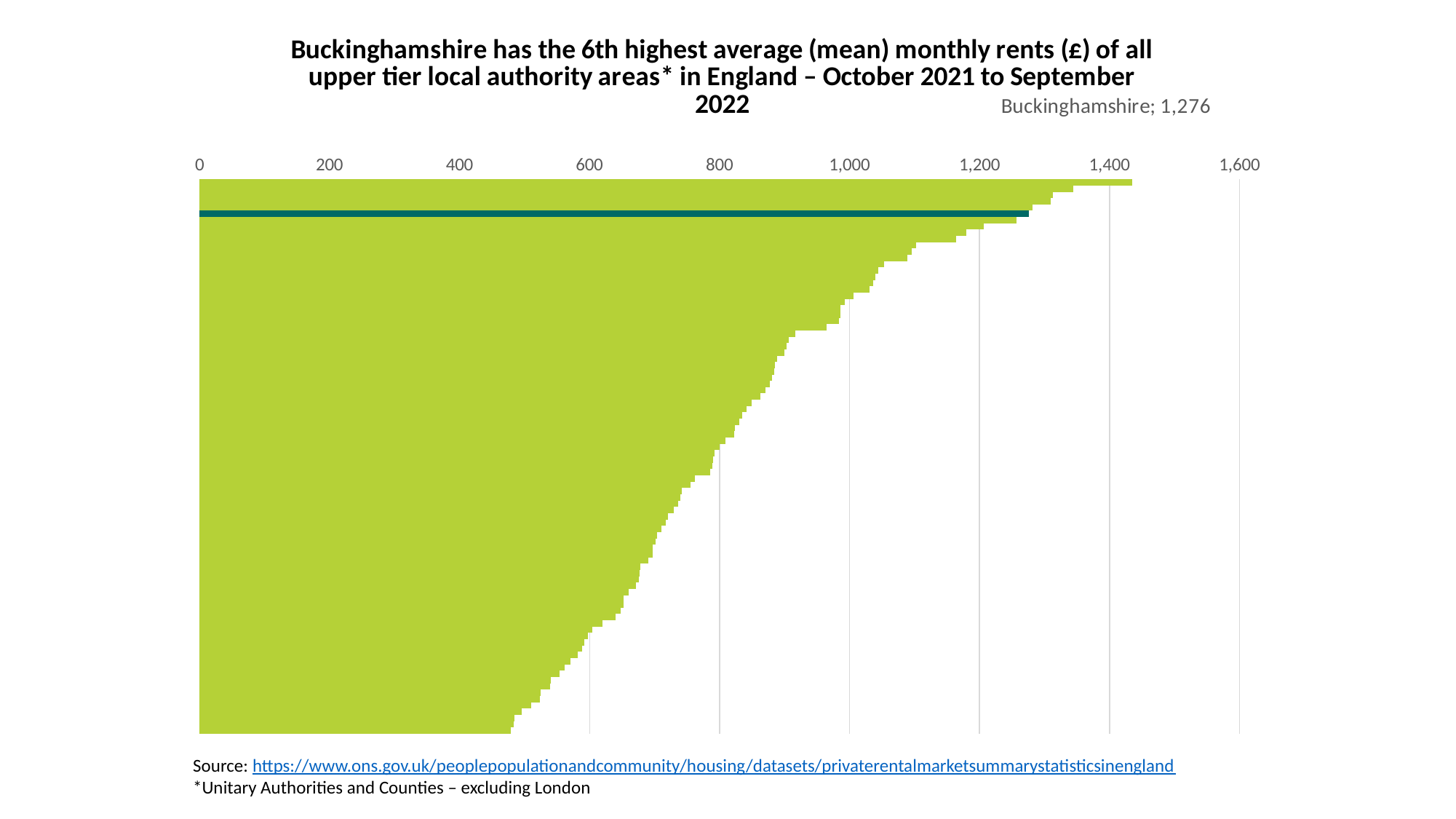
According to the slide title, what rank does Buckinghamshire hold for average monthly rents among upper tier local authority areas in England? 6th highest Is the shortest bar in the chart greater or less than 400? greater Is the value for Buckinghamshire greater or less than 1,200? greater Is the value for Buckinghamshire greater or less than 1,400? less What kind of chart is shown on the slide? bar chart What is the average monthly rent value shown for Buckinghamshire? 1,276 What is the highest tick value shown on the horizontal axis? 1,600 Do the bar values rise or fall going from the top of the chart to the bottom? fall